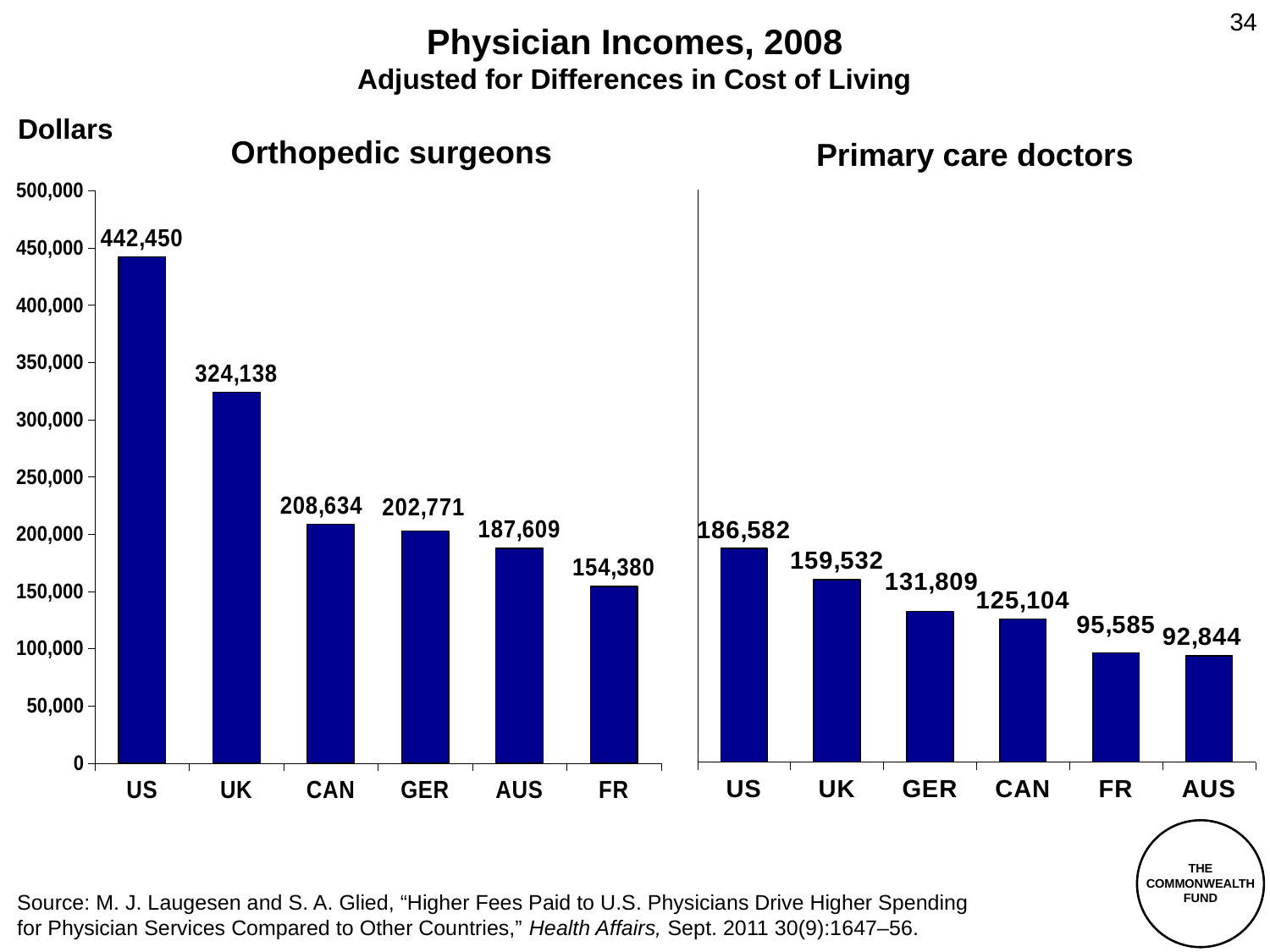
In the Orthopedic surgeons chart, what is the difference between the US and UK values? 118,312 In the Primary care doctors chart, what is the value for GER? 131,809 What is the subtitle of the slide under 'Physician Incomes, 2008'? Adjusted for Differences in Cost of Living What kind of chart is the Primary care doctors chart? bar chart In the Primary care doctors chart, is the value for UK greater or less than 150,000? greater In the Primary care doctors chart, what is the difference between the FR and AUS values? 2,741 In the Primary care doctors chart, do the values rise or fall from left to right? fall In the Primary care doctors chart, which country has the highest value? US How many countries are shown in the Orthopedic surgeons chart? 6 In the Orthopedic surgeons chart, which is larger, the value for CAN or the value for GER? CAN In the Orthopedic surgeons chart, which country has the lowest value? FR In the Orthopedic surgeons chart, what is the value for the US? 442,450